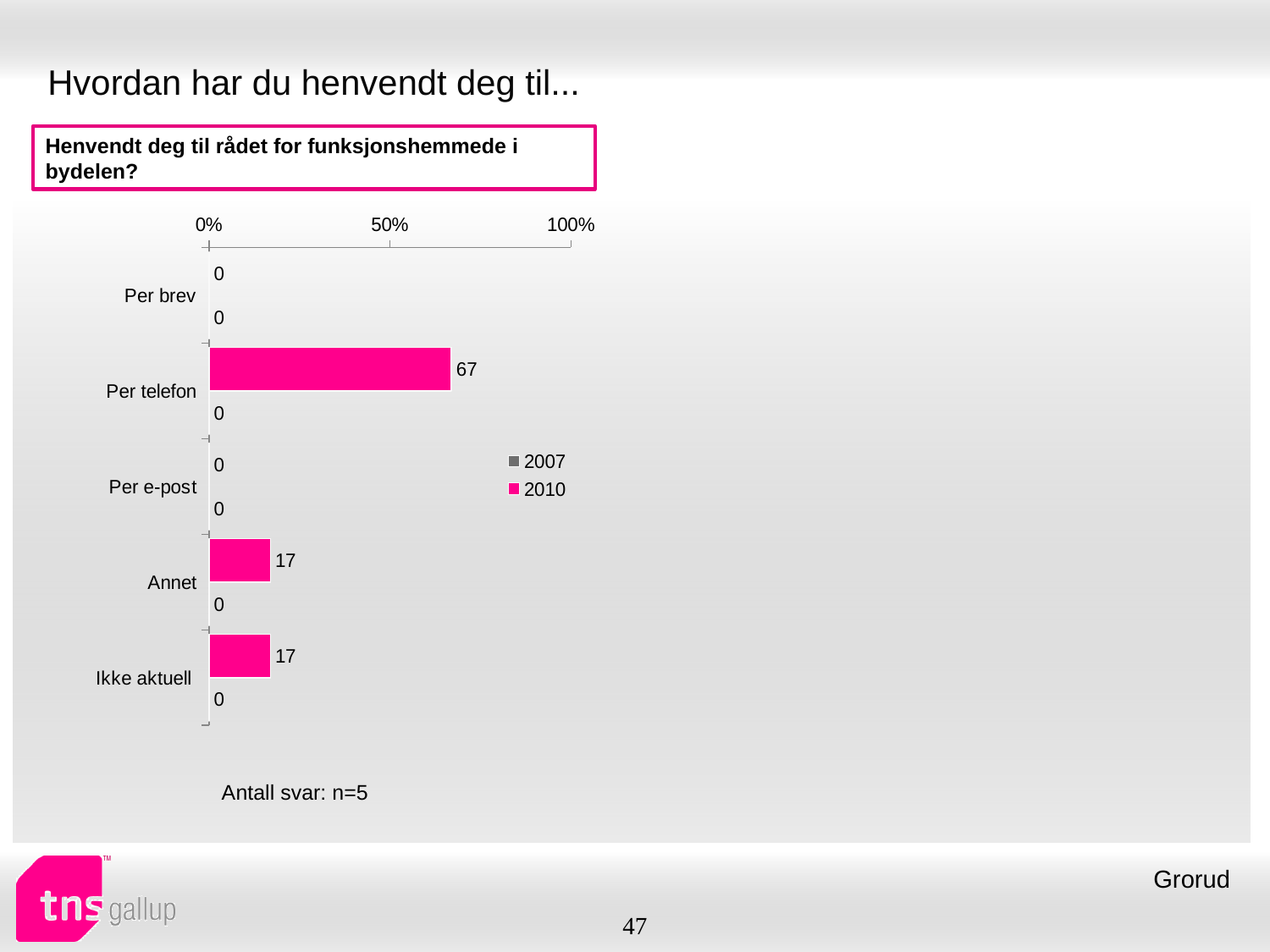
What is the value for Annet in 2010? 17 Which series is shown in pink in the legend? 2010 What is the value for Per telefon in 2010? 67 Which is larger for 2010: Per telefon or Ikke aktuell? Per telefon How many categories are shown on the chart? 5 What is the value for Per telefon in 2007? 0 Which category has the highest value for 2010? Per telefon What kind of chart is shown on the slide? bar chart What is the value for Ikke aktuell in 2010? 17 What is the difference between the 2010 values for Per telefon and Annet? 50 How many series does the legend list? 2 What is the value for Per brev in 2010? 0